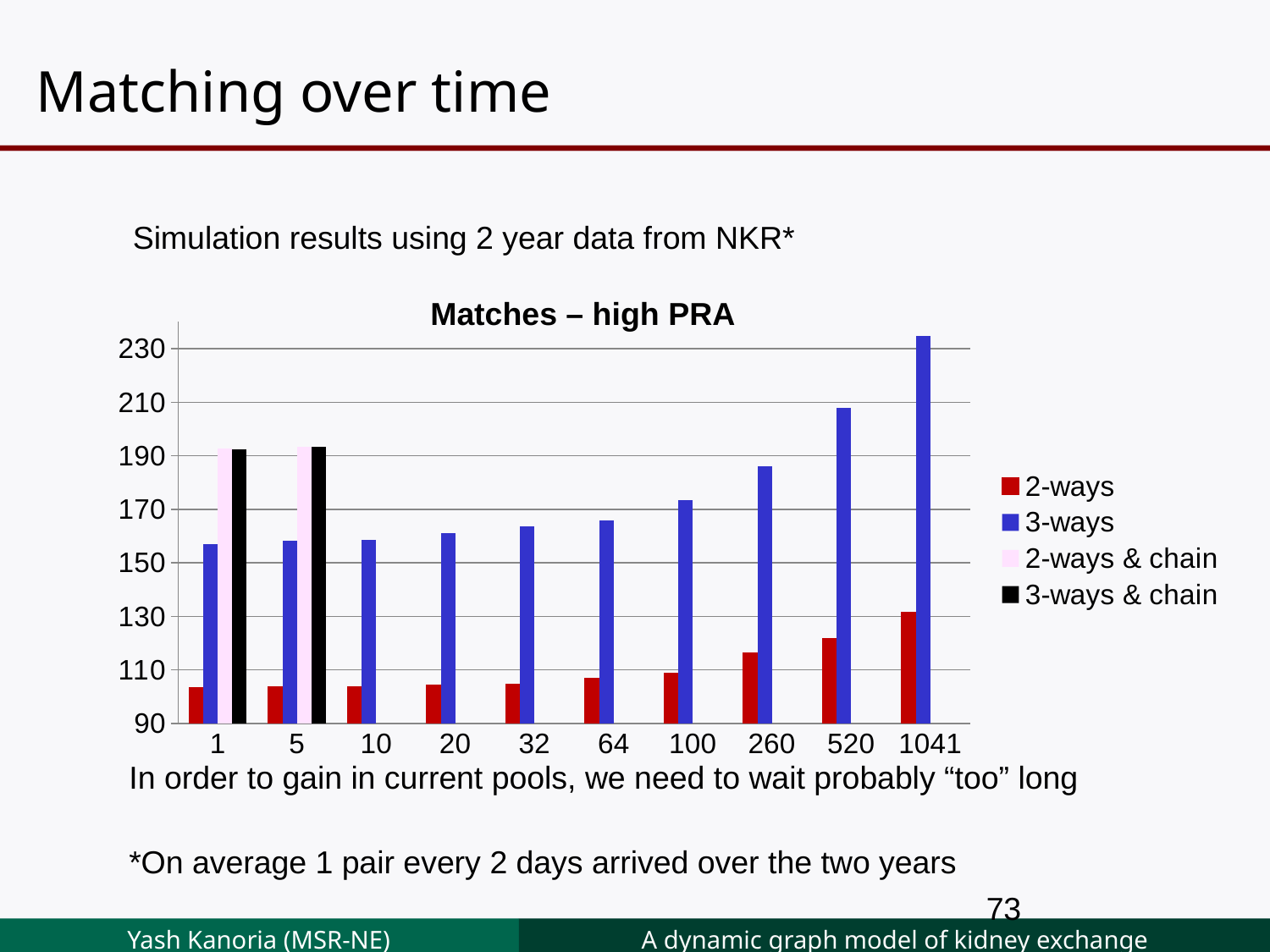
Is the value for 3-ways at category 1041 greater or less than 230? greater For which categories are bars for the 2-ways & chain and 3-ways & chain series shown? 1 and 5 What kind of chart is shown on the slide? bar chart At category 100, which is larger: the 2-ways value or the 3-ways value? 3-ways How many series does the legend of the chart list? 4 Is the value for 3-ways at category 520 greater or less than 210? less Is the value for 2-ways at category 520 greater or less than 110? greater Which category has the highest value for the 2-ways series? 1041 Which category has the highest value for the 3-ways series? 1041 Do the values of the 3-ways series rise or fall as you move along the x axis from 1 to 1041? rise What is the title of the chart? Matches – high PRA How many categories are shown along the x axis of the chart? 10